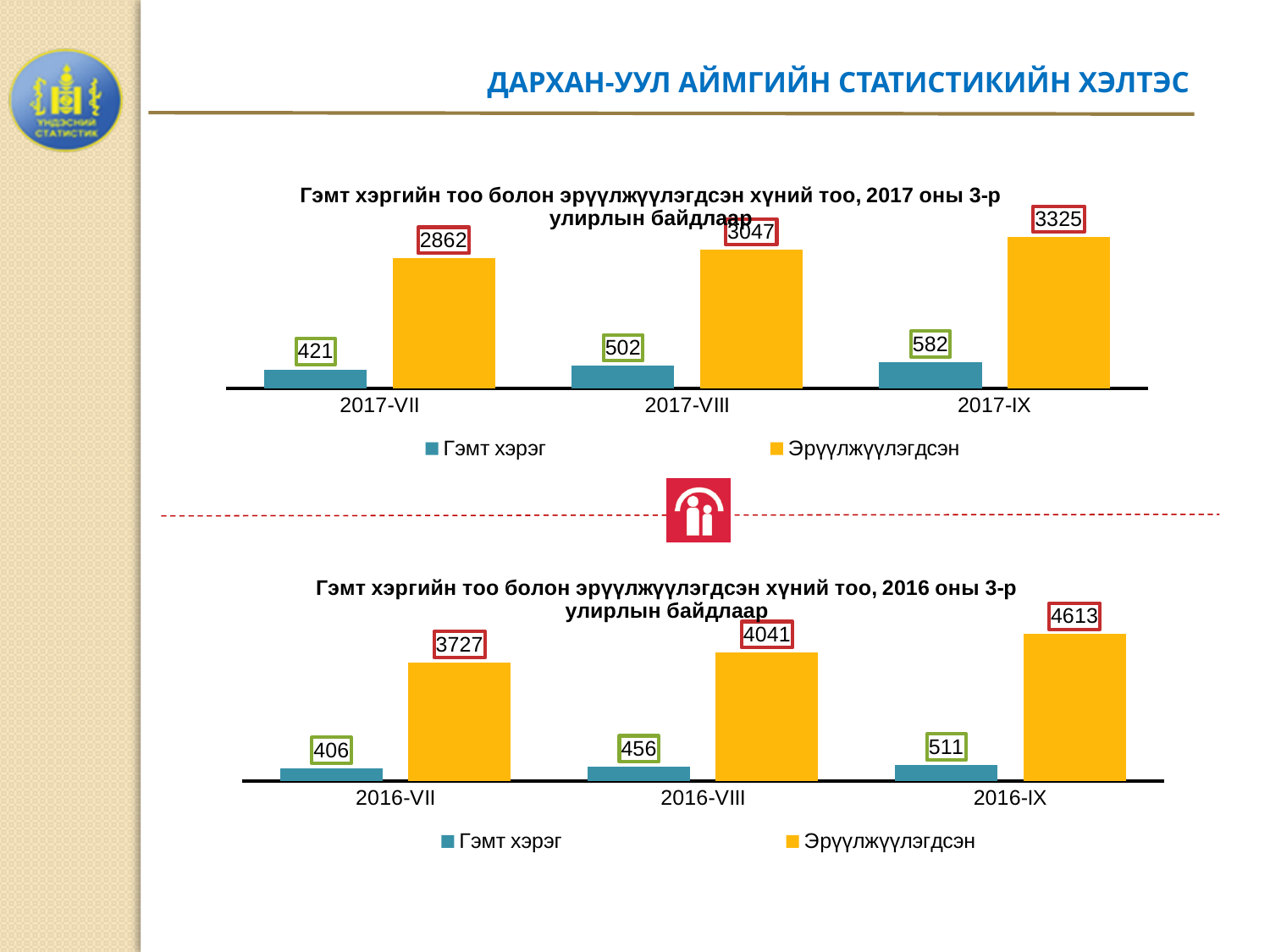
In the bottom chart (2016), what is the value of Гэмт хэрэг for 2016-IX? 511 In the bottom chart (2016), how many series does the legend list? 2 In the top chart (2017), what is the value of Гэмт хэрэг for 2017-VII? 421 In the bottom chart (2016), which month has the highest Гэмт хэрэг value? 2016-IX In the top chart (2017), which month has the highest Эрүүлжүүлэгдсэн value? 2017-IX In the top chart (2017), which month has the lowest Гэмт хэрэг value? 2017-VII In the top chart (2017), what is the value of Эрүүлжүүлэгдсэн for 2017-IX? 3325 In the top chart (2017), what is the difference between the Эрүүлжүүлэгдсэн values for 2017-VIII and 2017-VII? 185 What kind of chart is the top chart (2017)? bar chart In the top chart (2017), does Гэмт хэрэг rise or fall from 2017-VII to 2017-IX? rise In the bottom chart (2016), what is the value of Эрүүлжүүлэгдсэн for 2016-VIII? 4041 In the bottom chart (2016), what is the difference between the Гэмт хэрэг values for 2016-VIII and 2016-VII? 50